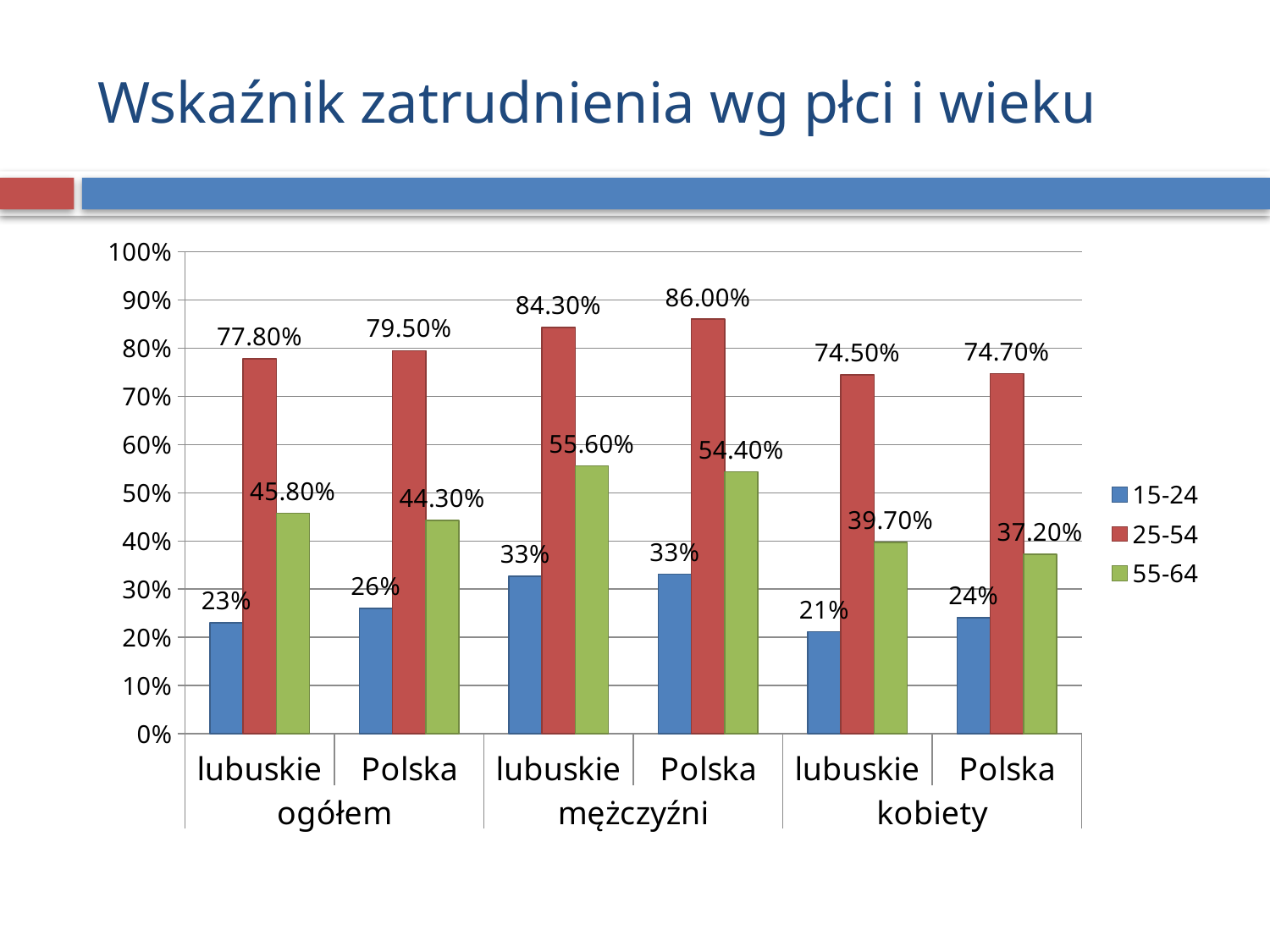
How many categories are shown on the x axis? 6 What is the value for the 55-64 series for lubuskie in the kobiety group? 39.70% What is the value for the 15-24 series for lubuskie in the ogółem group? 23% Which category has the lowest value in the 15-24 series? lubuskie (kobiety) How many series does the legend list? 3 What is the title of the slide? Wskaźnik zatrudnienia wg płci i wieku What is the difference between the 55-64 values for lubuskie and Polska in the mężczyźni group? 1.20% Which is larger: the 55-64 value for lubuskie in the ogółem group or the 55-64 value for Polska in the ogółem group? lubuskie (ogółem) What is the value for the 25-54 series for Polska in the mężczyźni group? 86.00% What kind of chart is shown on the slide? bar chart Which category has the highest value in the 25-54 series? Polska (mężczyźni) Is the 25-54 value for lubuskie in the kobiety group greater or less than 70%? greater